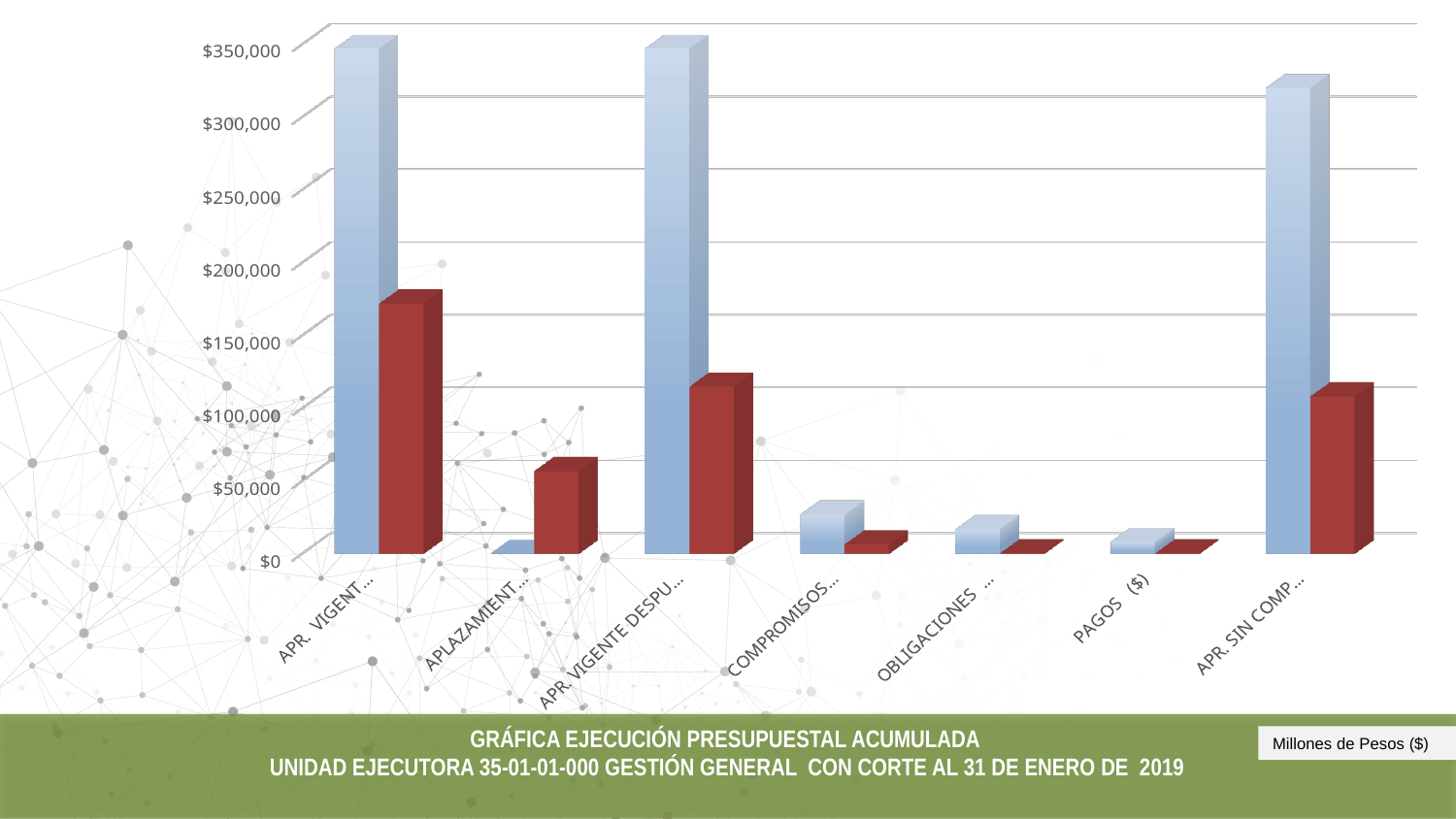
Which is larger: the red bar for APR. VIGENT... or the red bar for APR. VIGENTE DESPU...? APR. VIGENT... How many categories are shown along the x axis of the chart? 7 Is the value of the blue bar for APR. VIGENTE DESPU... greater or less than $300,000? greater Is the value of the blue bar for COMPROMISOS... greater or less than $50,000? less Is the value of the red bar for APLAZAMIENT... greater or less than $50,000? greater Which category has the highest red bar? APR. VIGENT... Which is larger: the blue bar for COMPROMISOS... or the blue bar for OBLIGACIONES...? COMPROMISOS... What kind of chart is shown on the slide? bar chart What unit is indicated in the box at the bottom right of the slide? Millones de Pesos ($)